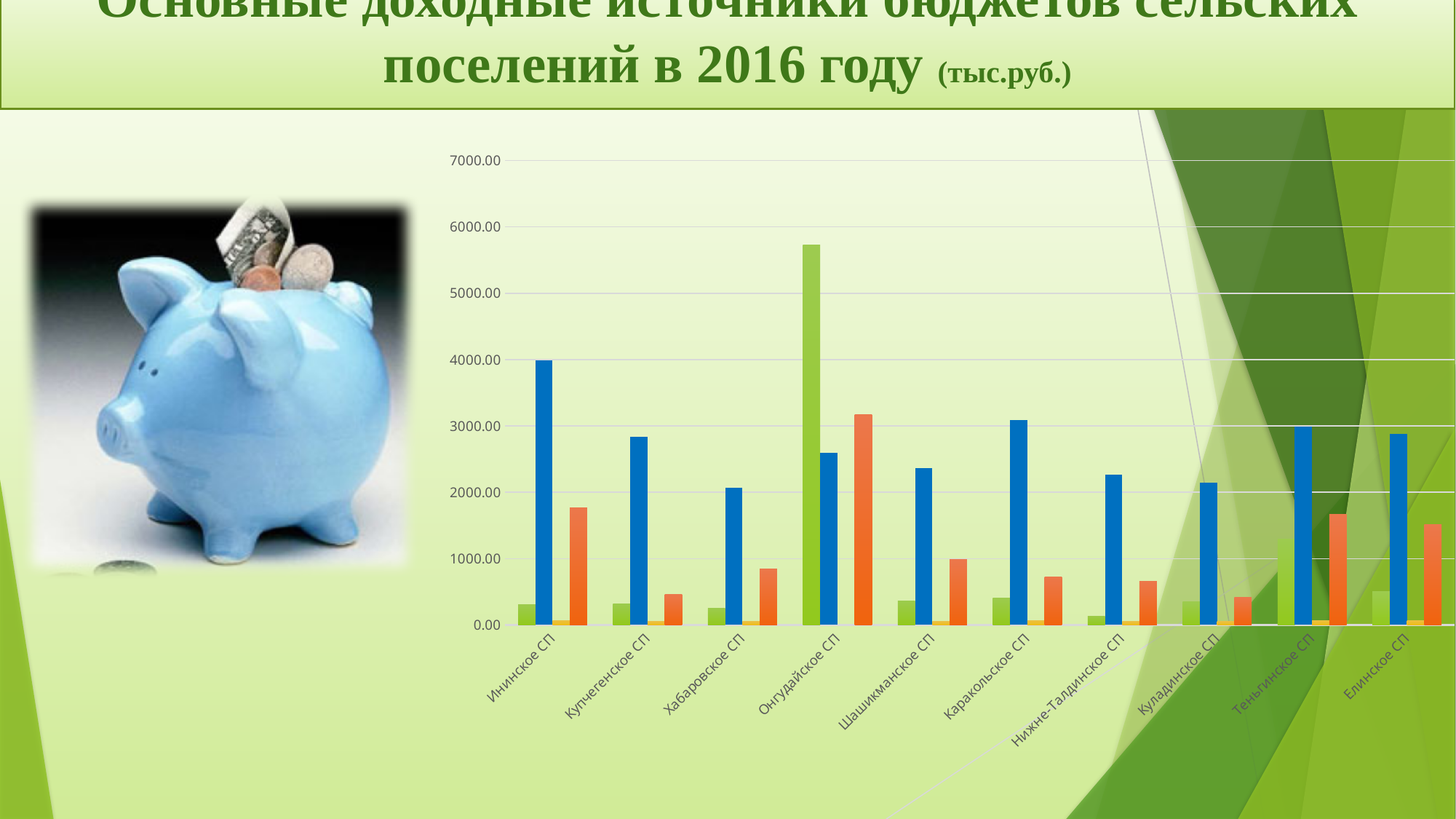
How many settlements (categories) are shown on the x axis of the chart? 10 Which is larger: the orange bar for Онгудайское СП or the orange bar for Ининское СП? Онгудайское СП What kind of chart is shown on the slide? bar chart Which category has the tallest blue bar? Ининское СП Which category has the tallest bar in the whole chart? Онгудайское СП Is the orange bar for Ининское СП greater or less than 2000.00? less Is the orange bar for Онгудайское СП greater or less than 2000.00? greater In what units are the values in the chart expressed, according to the slide title? тыс.руб. Is the orange bar for Каракольское СП greater or less than 1000.00? less Which is larger: the blue bar for Ининское СП or the blue bar for Купчегенское СП? Ининское СП